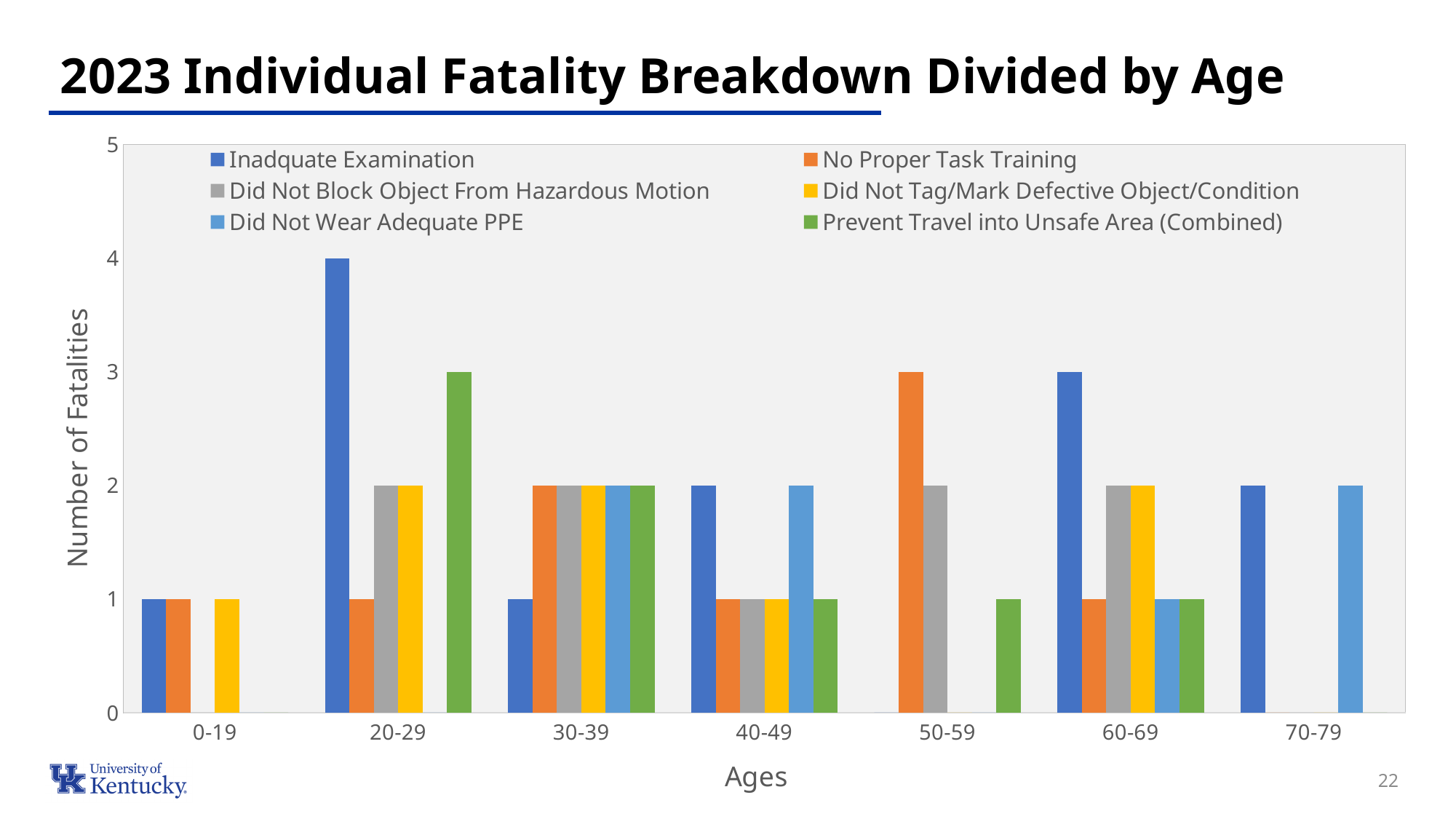
What is the number of fatalities for Inadquate Examination in the 20-29 age group? 4 What is the label of the y axis? Number of Fatalities What is the number of fatalities for Prevent Travel into Unsafe Area (Combined) in the 20-29 age group? 3 What is the number of fatalities for No Proper Task Training in the 50-59 age group? 3 What is the number of fatalities for Did Not Wear Adequate PPE in the 70-79 age group? 2 Which age group has the highest value for Inadquate Examination? 20-29 What type of chart is shown on the slide? Bar chart How many series does the legend list? 6 What is the difference between Inadquate Examination in the 20-29 group and Inadquate Examination in the 60-69 group? 1 What is the title of the chart? 2023 Individual Fatality Breakdown Divided by Age Which is larger in the 50-59 age group: No Proper Task Training or Did Not Block Object From Hazardous Motion? No Proper Task Training How many age groups are shown on the x axis? 7